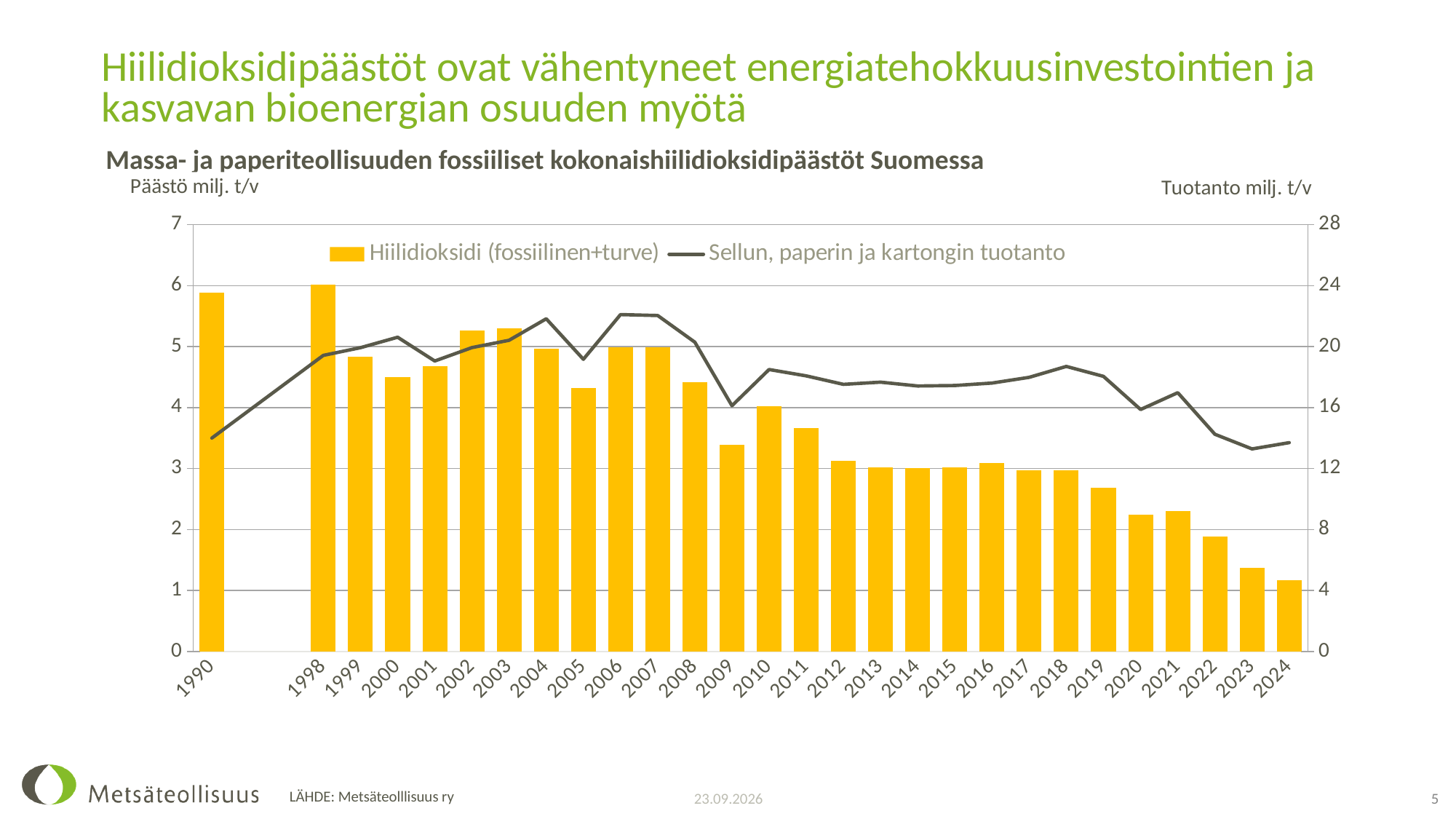
Is the Hiilidioksidi (fossiilinen+turve) value for 2019 greater or less than 3? less Is the Hiilidioksidi (fossiilinen+turve) value for 2005 greater or less than 4? greater How many series does the legend list? 2 Is the Hiilidioksidi (fossiilinen+turve) value for 2024 greater or less than 2? less Which year has the larger Hiilidioksidi (fossiilinen+turve) bar, 2004 or 2005? 2004 Which year has the lowest bar for Hiilidioksidi (fossiilinen+turve)? 2024 What kind of chart is shown on the slide? A combined bar and line chart How many years are shown on the x axis of the chart? 28 Do the Hiilidioksidi (fossiilinen+turve) bars rise or fall from 2007 to 2024? fall